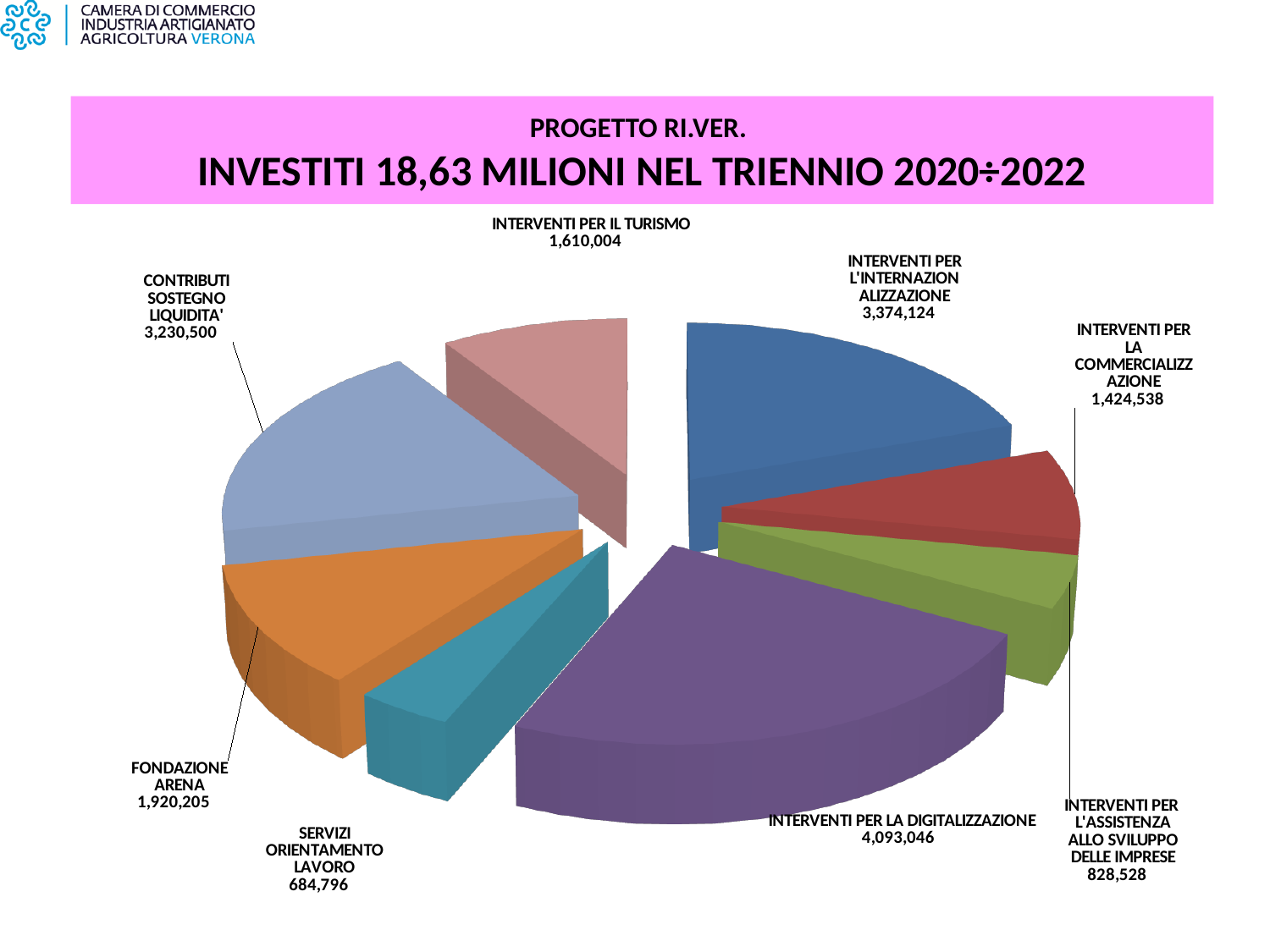
What is the value for INTERVENTI PER LA DIGITALIZZAZIONE? 4,093,046 What is the value for CONTRIBUTI SOSTEGNO LIQUIDITA'? 3,230,500 What type of chart is shown on the slide? Pie chart How many slices does the pie chart have? 8 Which category has the largest value in the pie chart? INTERVENTI PER LA DIGITALIZZAZIONE What is the difference between FONDAZIONE ARENA and INTERVENTI PER IL TURISMO? 310,201 What is the value for INTERVENTI PER L'ASSISTENZA ALLO SVILUPPO DELLE IMPRESE? 828,528 Which is larger, INTERVENTI PER IL TURISMO or INTERVENTI PER LA COMMERCIALIZZAZIONE? INTERVENTI PER IL TURISMO What total investment does the chart title state for the 2020÷2022 period? 18,63 MILIONI Which category has the smallest value in the pie chart? SERVIZI ORIENTAMENTO LAVORO What is the difference between INTERVENTI PER LA DIGITALIZZAZIONE and INTERVENTI PER L'INTERNAZIONALIZZAZIONE? 718,922 What is the value for FONDAZIONE ARENA? 1,920,205